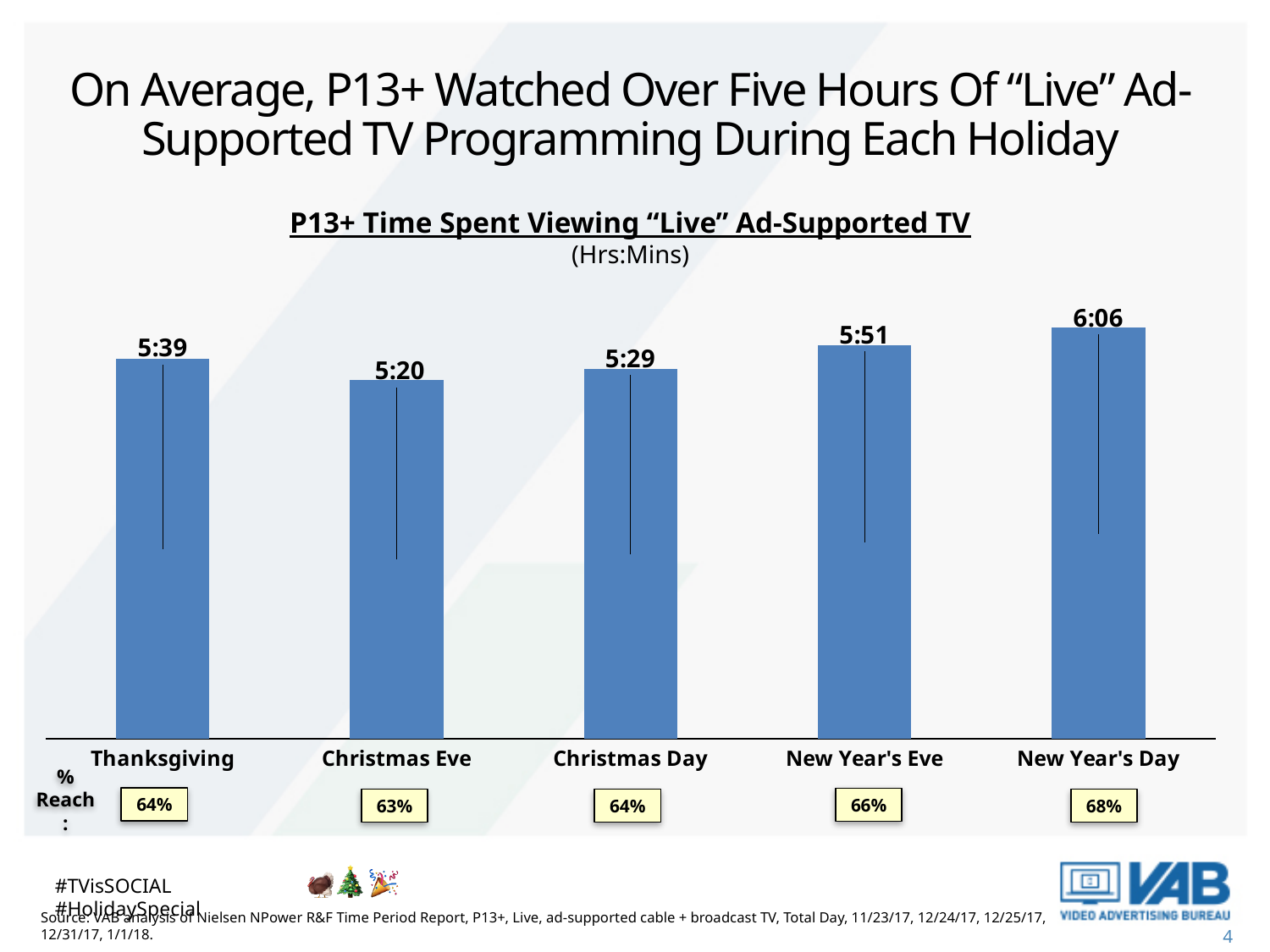
Which holiday has the lowest time spent viewing "live" ad-supported TV? Christmas Eve What is the P13+ time spent viewing "live" ad-supported TV on Thanksgiving? 5:39 What is the % Reach shown for New Year's Day? 68% In what units are the chart values expressed, according to the subtitle? Hrs:Mins What is the % Reach shown for Christmas Eve? 63% Which is larger, the time spent viewing on Christmas Day or on Thanksgiving? Thanksgiving Which holiday has the highest time spent viewing "live" ad-supported TV? New Year's Day How many holidays are shown in the chart? 5 What is the time spent viewing value shown for Christmas Eve? 5:20 How many minutes longer is the time spent viewing on New Year's Day than on Christmas Eve? 46 minutes What is the time spent viewing value shown for New Year's Eve? 5:51 What kind of chart is used to show P13+ time spent viewing? Bar chart